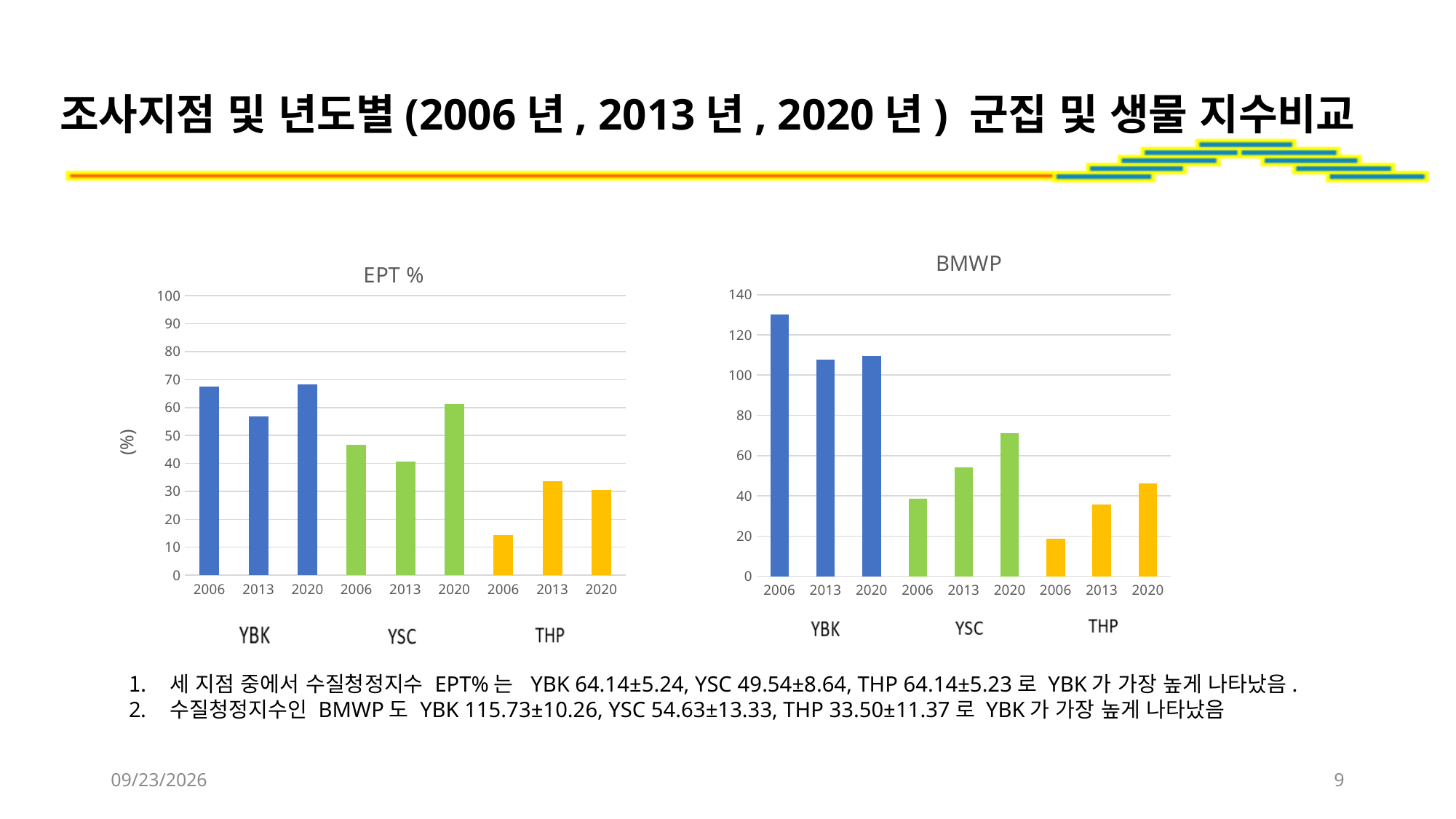
In the BMWP chart, do the YSC values rise or fall from 2006 to 2020? rise In the BMWP chart, which site and year has the lowest value? THP 2006 In the EPT % chart, how many bars are plotted? 9 In the EPT % chart, is the value for THP 2006 greater or less than 20? less What is the y-axis label of the EPT % chart? (%) In the BMWP chart, is the value for YBK 2006 greater or less than 120? greater In the EPT % chart, which site and year has the lowest value? THP 2006 In the BMWP chart, which site and year has the highest value? YBK 2006 In the EPT % chart, is the value for YSC 2020 greater or less than 50? greater In the EPT % chart, which is larger, YBK 2013 or YSC 2013? YBK 2013 What kind of chart is the EPT % chart on the left? bar chart In the BMWP chart, which is larger, YSC 2020 or THP 2020? YSC 2020